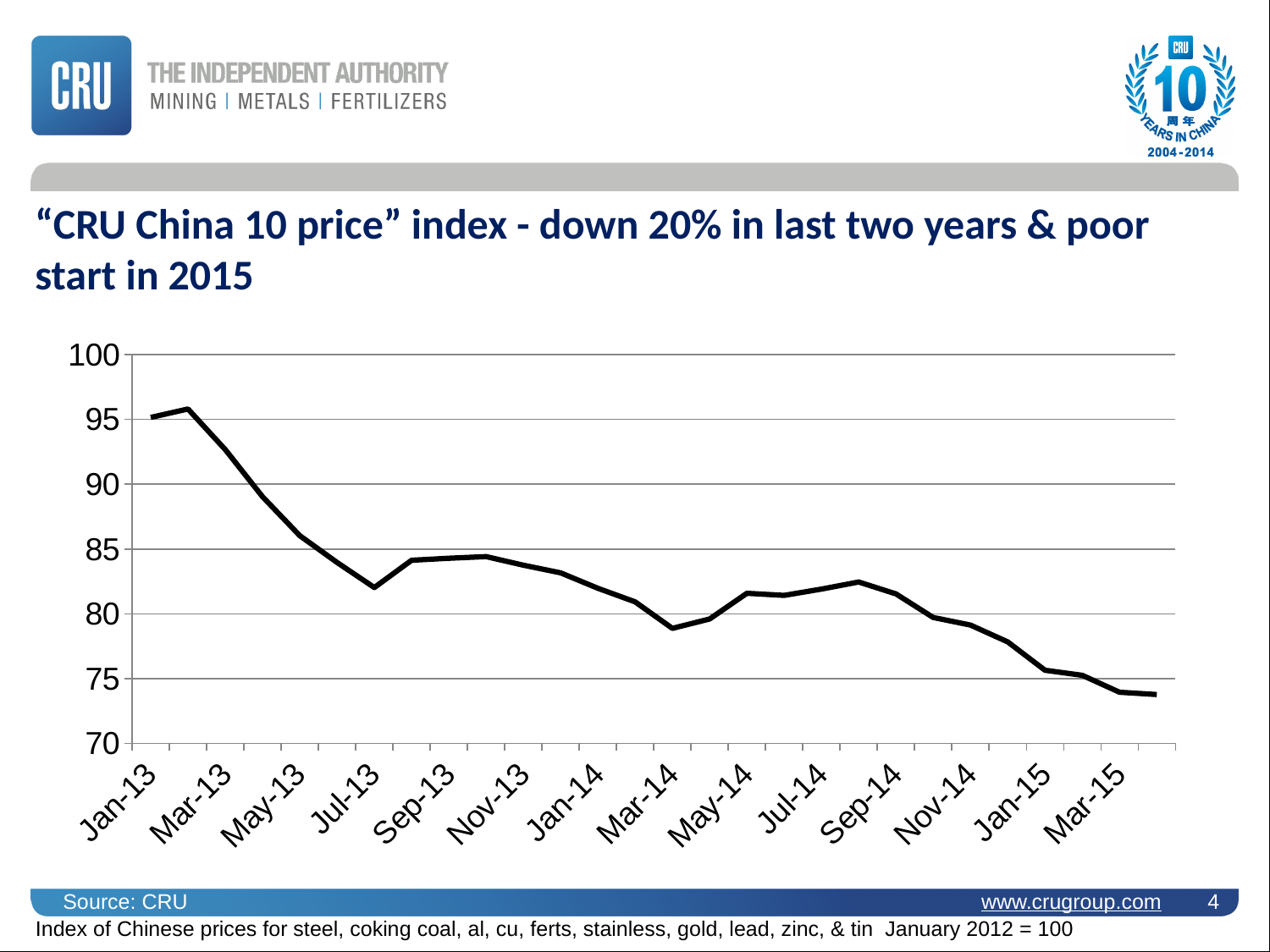
Is the index value for Sep-14 greater or less than 80? greater Which is higher, the index value for Jan-13 or for Mar-15? Jan-13 Is the index value for May-13 greater or less than 85? greater What kind of chart is shown on the slide? line chart Which is higher, the index value for Sep-13 or for Mar-14? Sep-13 How many month labels are shown on the x axis? 14 Does the CRU China 10 price index generally rise or fall from Jan-13 to Mar-15? fall Which is lower, the index value for Nov-13 or for Nov-14? Nov-14 What is the source cited for the chart? CRU Is the index value for Mar-15 greater or less than 75? less